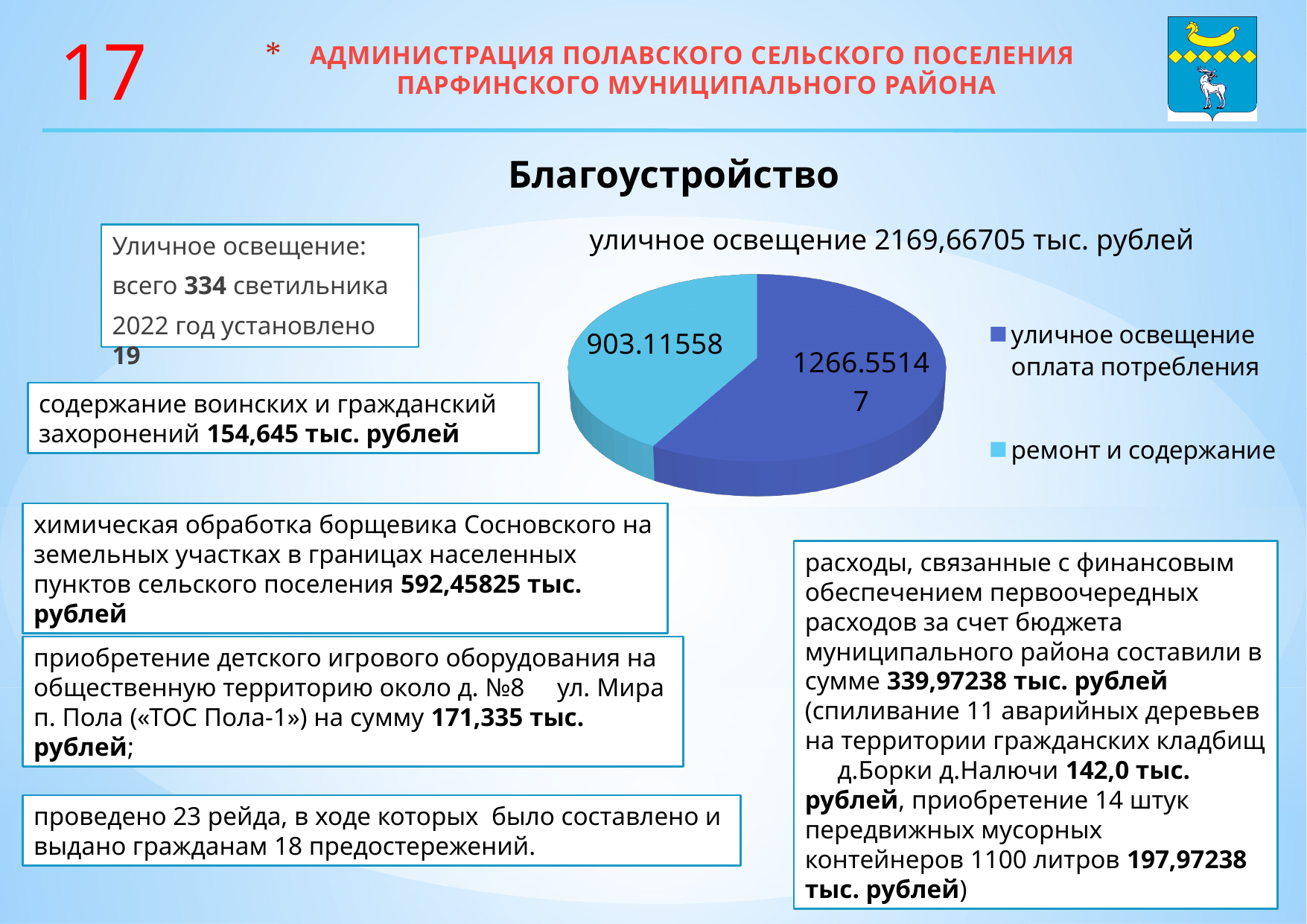
What colour is the 'ремонт и содержание' slice in the pie chart? light blue How many slices does the pie chart have? 2 Which slice of the pie chart is the largest? уличное освещение оплата потребления What is the title of the pie chart? уличное освещение 2169,66705 тыс. рублей What is the value of the 'уличное освещение оплата потребления' slice in the pie chart? 1266.55147 Which is larger in the pie chart: 'уличное освещение оплата потребления' or 'ремонт и содержание'? уличное освещение оплата потребления What type of chart is shown on the slide? pie chart Which slice of the pie chart is the smallest? ремонт и содержание What is the value of the 'ремонт и содержание' slice in the pie chart? 903.11558 How many entries does the pie chart legend list? 2 What is the difference between the 'уличное освещение оплата потребления' and 'ремонт и содержание' values in the pie chart? 363.39589 What is the total of the two slices in the pie chart? 2169.66705